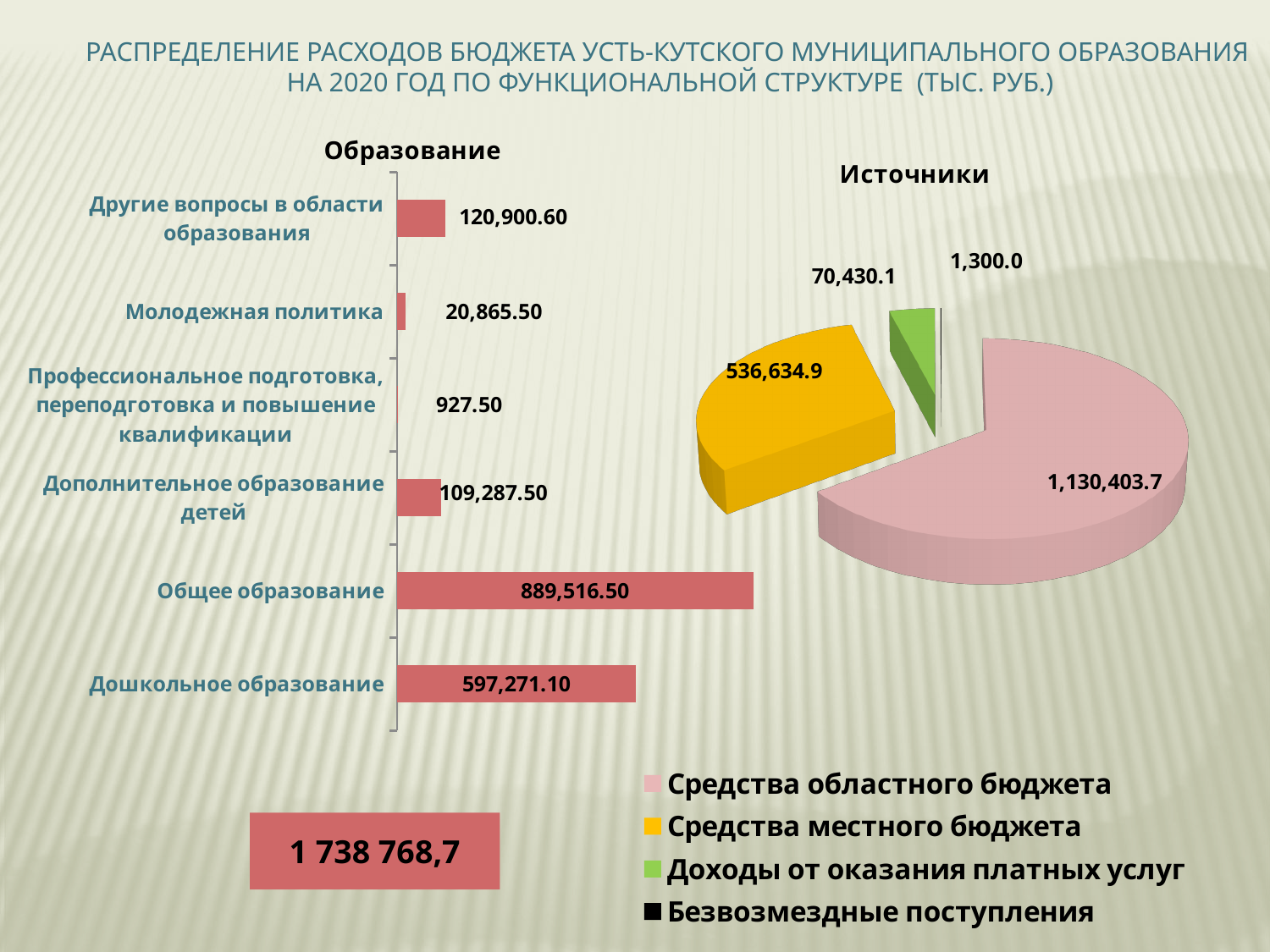
In the bar chart titled Образование, what is the value for Общее образование? 889,516.50 In the bar chart titled Образование, which is larger: Другие вопросы в области образования or Дополнительное образование детей? Другие вопросы в области образования In the bar chart titled Образование, what is the value for Молодежная политика? 20,865.50 In the bar chart titled Образование, which category has the highest value? Общее образование In the pie chart titled Источники, which source has the largest value? Средства областного бюджета In the pie chart titled Источники, what is the difference between Средства областного бюджета and Средства местного бюджета? 593,768.8 What kind of chart is the chart titled Образование? bar chart In the pie chart titled Источники, what is the value for Средства местного бюджета? 536,634.9 In the bar chart titled Образование, which category has the lowest value? Профессиональное подготовка, переподготовка и повышение квалификации How many categories does the bar chart titled Образование show? 6 In the bar chart titled Образование, what is the difference between Общее образование and Дошкольное образование? 292,245.40 How many entries does the legend of the pie chart titled Источники list? 4